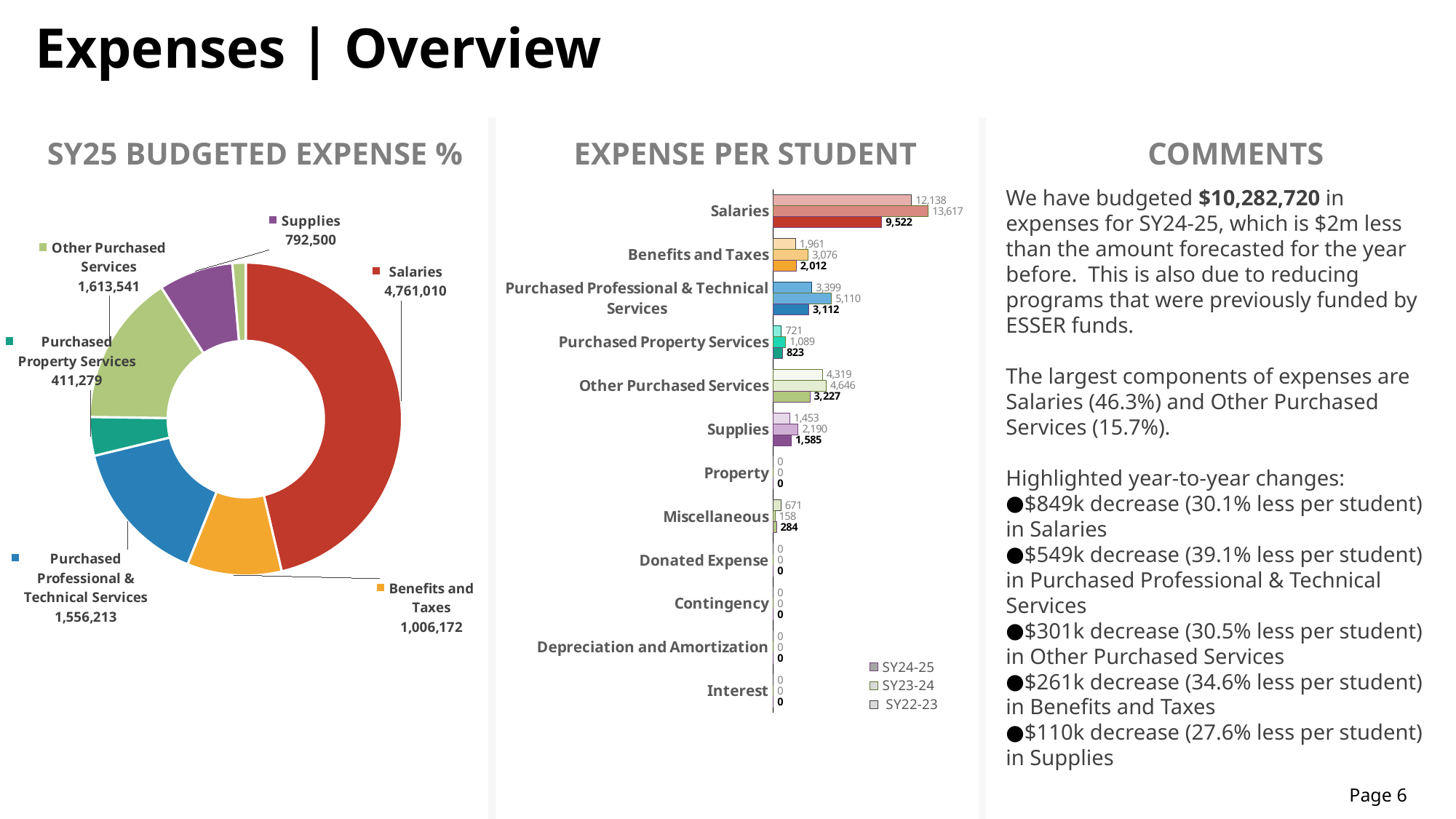
In the SY25 BUDGETED EXPENSE % chart, which is larger: Purchased Property Services or Supplies? Supplies How many expense categories are shown on the EXPENSE PER STUDENT chart? 12 In the SY25 BUDGETED EXPENSE % chart, what is the difference between Other Purchased Services and Purchased Professional & Technical Services? 57,328 How many series does the legend of the EXPENSE PER STUDENT chart list? 3 In the EXPENSE PER STUDENT chart, what is the SY24-25 value for Salaries? 9,522 In the SY25 BUDGETED EXPENSE % chart, what is the value shown for Supplies? 792,500 In the EXPENSE PER STUDENT chart, what is the SY23-24 value for Purchased Professional & Technical Services? 5,110 What kind of chart is the SY25 BUDGETED EXPENSE % chart? Donut (pie) chart In the EXPENSE PER STUDENT chart, what is the difference between the SY23-24 and SY24-25 values for Salaries? 4,095 In the SY25 BUDGETED EXPENSE % chart, what is the value shown for Salaries? 4,761,010 What kind of chart is the EXPENSE PER STUDENT chart? Bar chart In the SY25 BUDGETED EXPENSE % chart, which category has the largest slice? Salaries